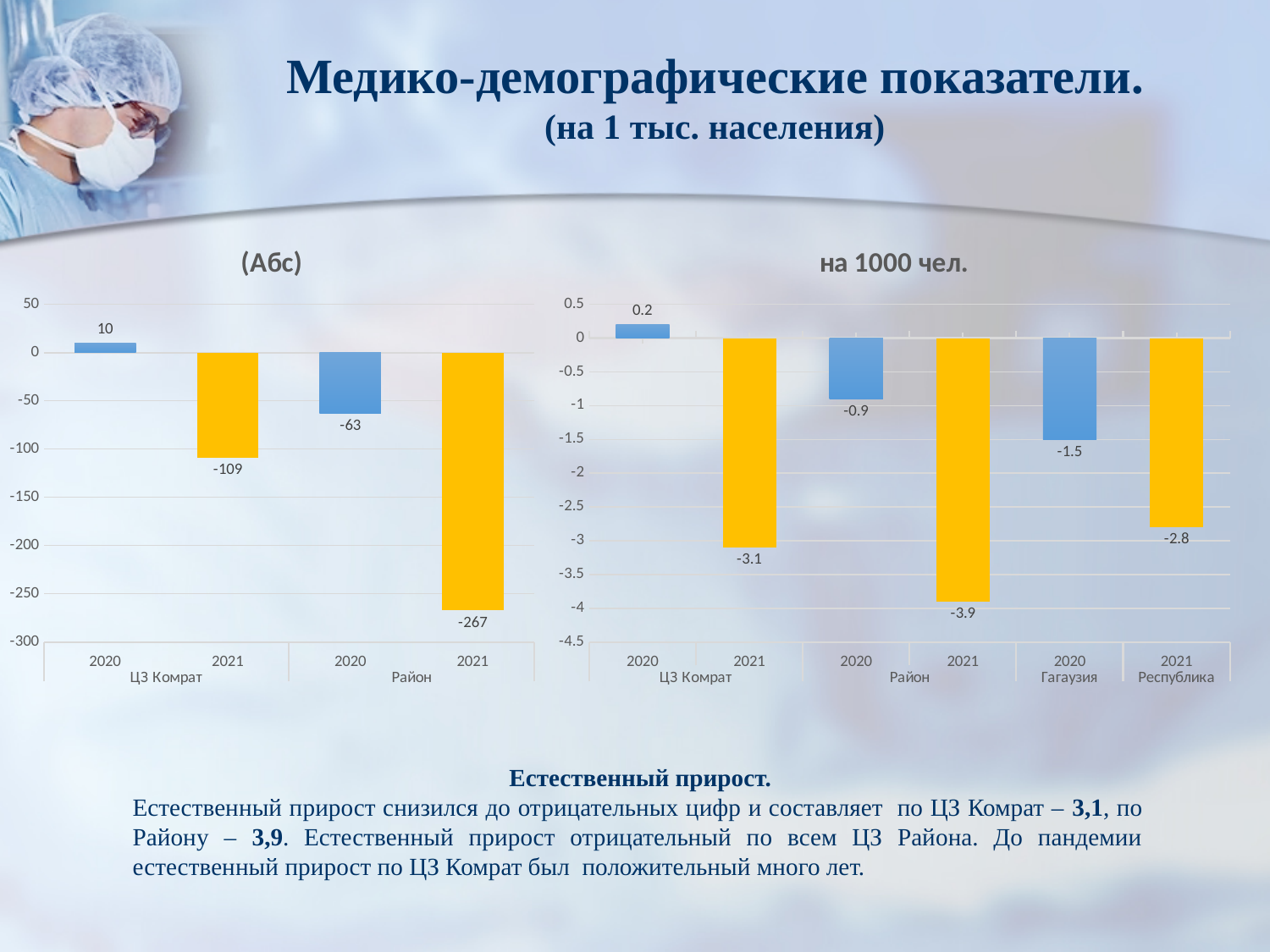
In the chart titled "на 1000 чел.", what is the value for Республика in 2021? -2.8 In the chart titled "(Абс)", what is the value for ЦЗ Комрат in 2020? 10 In the chart titled "(Абс)", what is the difference between the Район 2020 value and the Район 2021 value? 204 In the chart titled "(Абс)", which bar has the lowest value? Район 2021 In the chart titled "на 1000 чел.", which bar has the highest value? ЦЗ Комрат 2020 In the chart titled "(Абс)", how many bars are plotted? 4 In the chart titled "(Абс)", what is the value for ЦЗ Комрат in 2021? -109 What type of chart is the chart titled "на 1000 чел."? Bar chart In the chart titled "на 1000 чел.", what is the value for Район in 2021? -3.9 In the chart titled "на 1000 чел.", which is larger: the value for ЦЗ Комрат in 2021 or the value for Республика in 2021? Республика 2021 In the chart titled "на 1000 чел.", what is the value for Гагаузия in 2020? -1.5 In the chart titled "(Абс)", what is the value for Район in 2021? -267